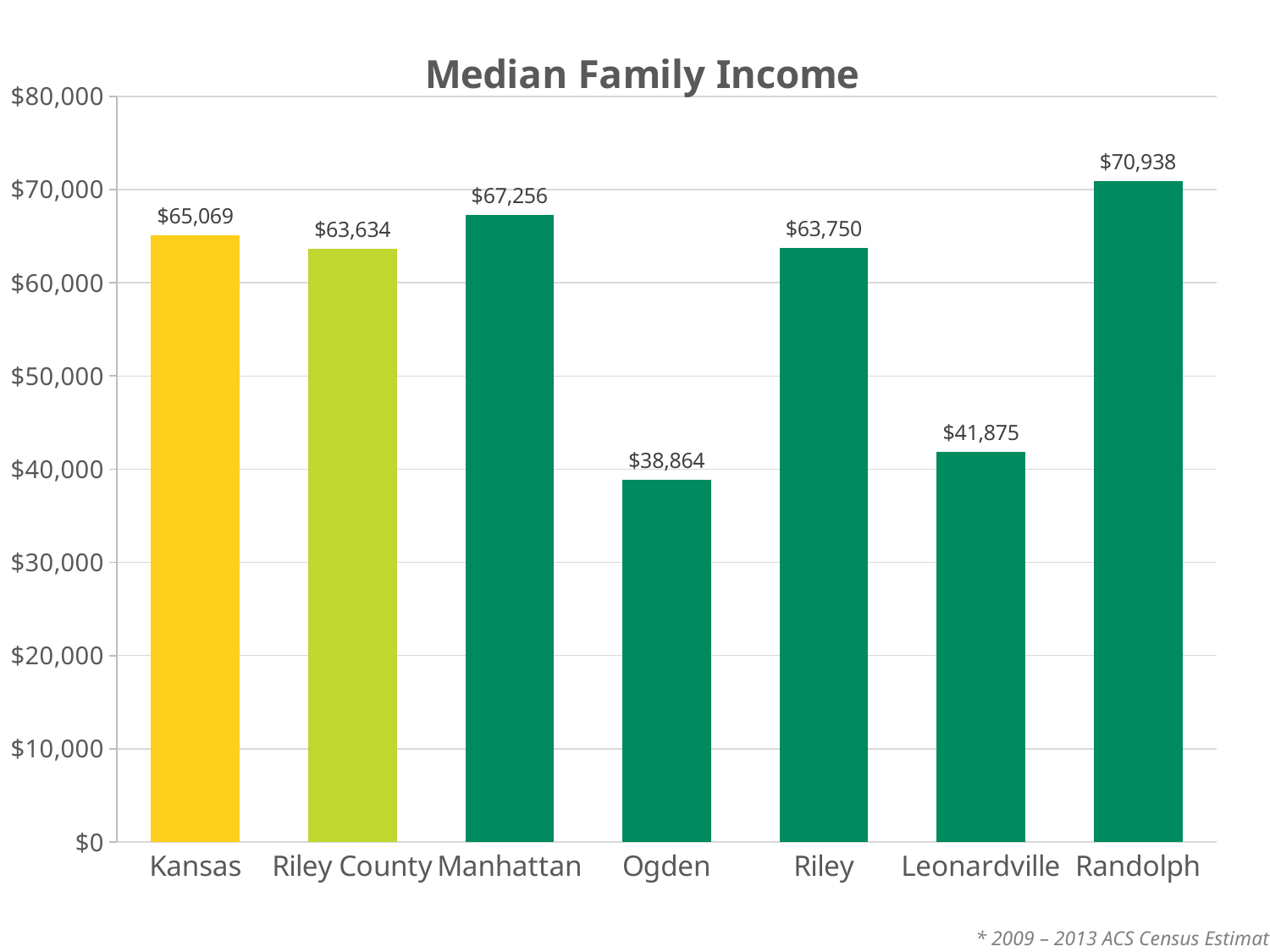
Which category has the lowest median family income? Ogden Which has a higher median family income, Manhattan or Leonardville? Manhattan What is the median family income for Kansas? $65,069 What kind of chart is shown on the slide? Bar chart Which category has the highest median family income? Randolph How many categories are shown on the x axis? 7 What is the median family income for Ogden? $38,864 What is the title of the chart? Median Family Income What is the difference between the median family income of Kansas and Riley County? $1,435 What is the difference between the median family income of Randolph and Ogden? $32,074 Is the median family income for Leonardville greater or less than $40,000? greater What is the median family income for Manhattan? $67,256